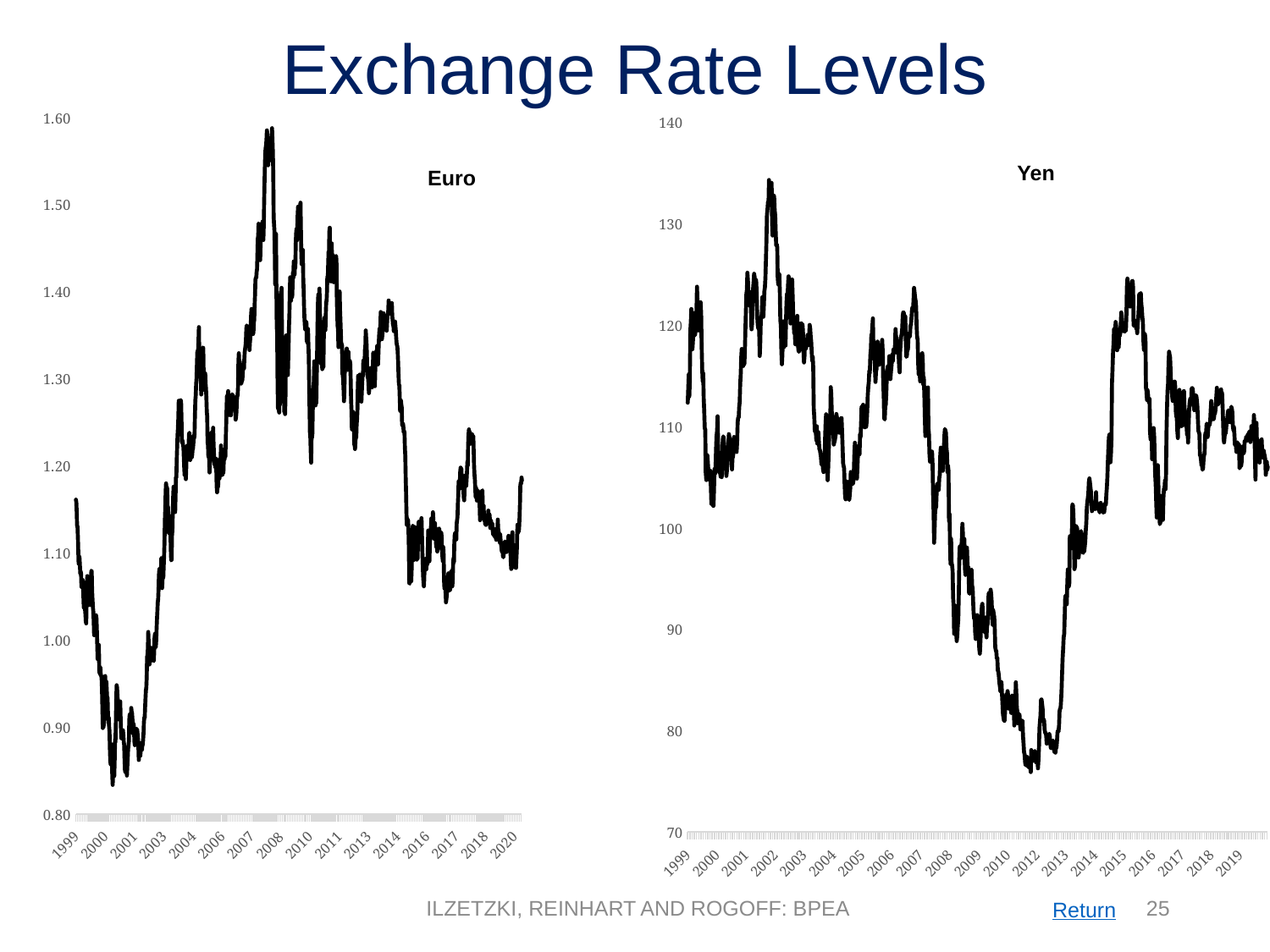
In the Yen chart, is the value in 2015 greater or less than 110? greater In the Yen chart, is the lowest value around 2012 greater or less than 80? less In the Euro chart, is the lowest value around 2001 greater or less than 0.90? less What is the highest value shown on the y axis of the Yen chart? 140 How many charts are shown on the slide? 2 What is the title of the chart on the right? Yen In the Yen chart, does the value rise or fall from 2007 to 2012? fall What kind of chart is the Euro chart on the left? line chart In the Euro chart, does the value rise or fall from 2014 to 2016? fall